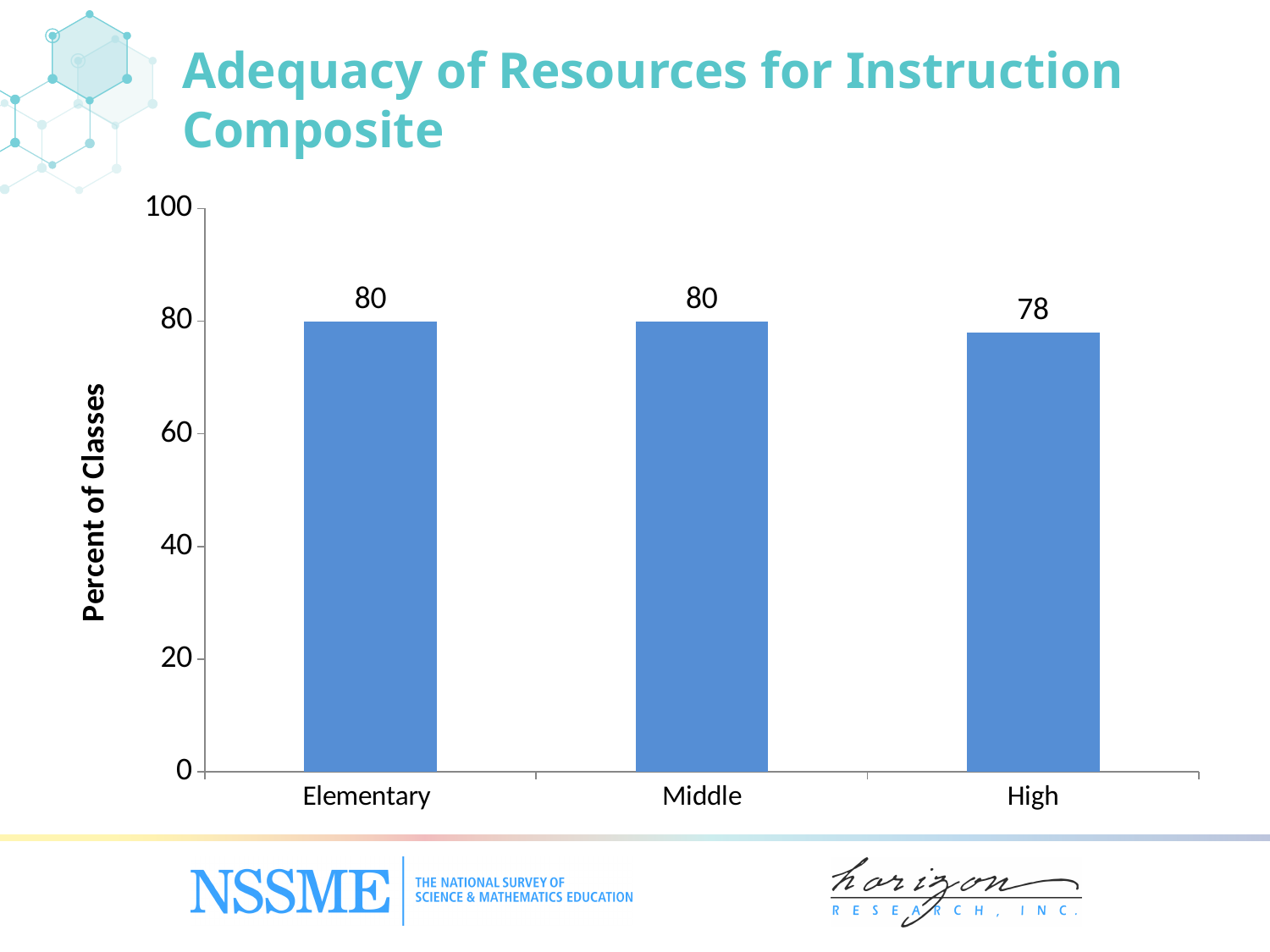
Is the value for High greater or less than 80? less What is the value for Elementary? 80 What is the label of the y axis? Percent of Classes Which category has the lowest value? High What is the value for High? 78 Is the value for Elementary greater or less than 60? greater What is the title of the slide? Adequacy of Resources for Instruction Composite What is the value for Middle? 80 What kind of chart is shown on the slide? bar chart Which is larger, the value for Middle or the value for High? Middle How many categories are shown on the x axis? 3 What is the difference between the values for Elementary and High? 2